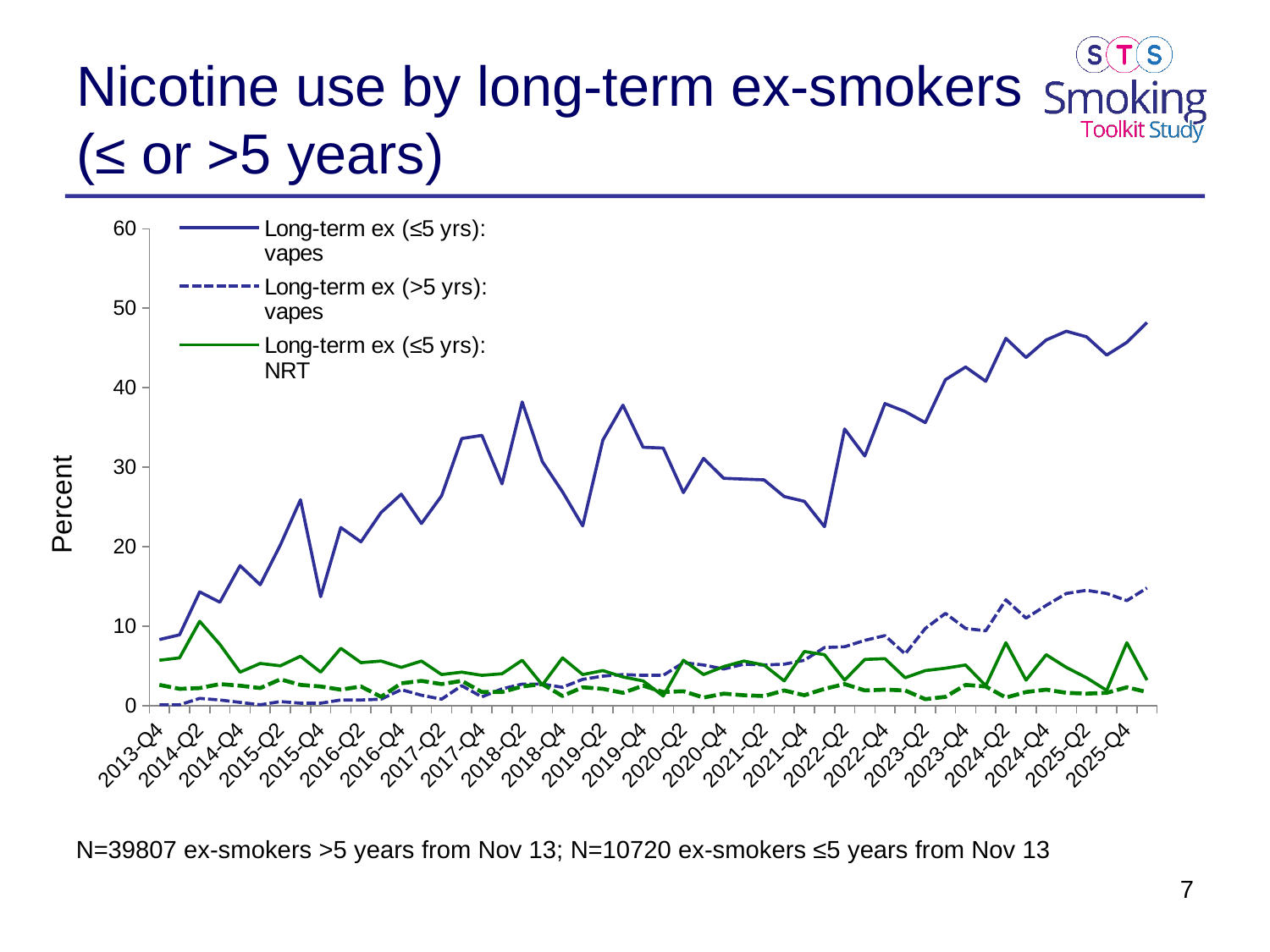
Is the value for Long-term ex (≤5 yrs): vapes at 2025-Q4 greater or less than 40? greater Is the value for Long-term ex (≤5 yrs): vapes at 2018-Q2 greater or less than 30? greater What is the label on the vertical axis of the chart? Percent Is the value for Long-term ex (≤5 yrs): vapes at 2013-Q4 greater or less than 10? less At 2025-Q4, which is higher: Long-term ex (≤5 yrs): vapes or Long-term ex (≤5 yrs): NRT? Long-term ex (≤5 yrs): vapes Which legend series is drawn with a dashed line? Long-term ex (>5 yrs): vapes Does the value for Long-term ex (≤5 yrs): vapes rise or fall overall from 2013-Q4 to 2025-Q4? rise Does the value for Long-term ex (>5 yrs): vapes rise or fall overall from 2013-Q4 to 2025-Q4? rise What kind of chart is shown on the slide? line chart How many series does the chart's legend list? 3